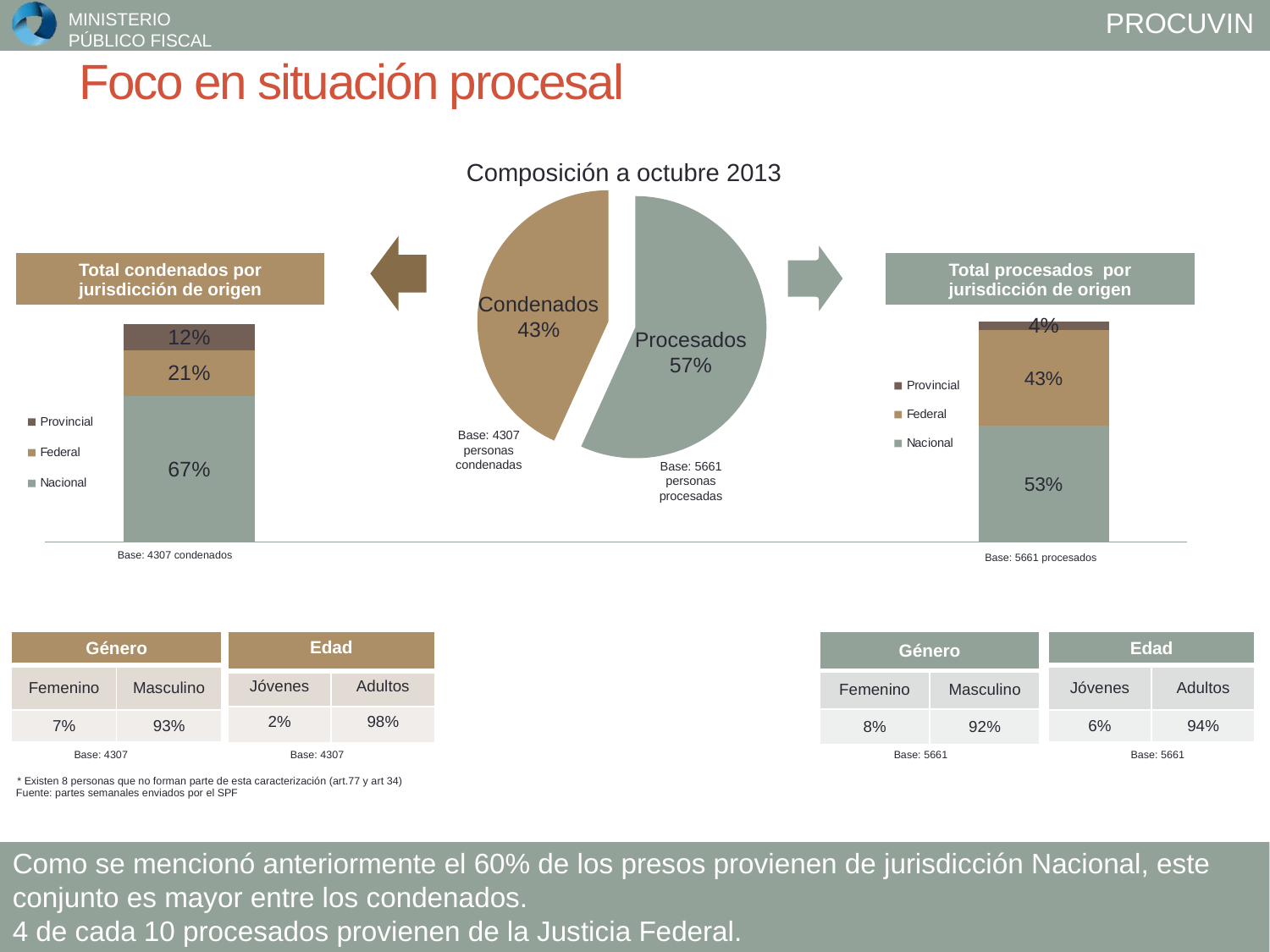
In the chart 'Total condenados por jurisdicción de origen', what is the difference between the Nacional and Federal values? 46% In the chart 'Total condenados por jurisdicción de origen', what is the value for Federal? 21% In the chart 'Total condenados por jurisdicción de origen', what is the value for Nacional? 67% In the pie chart 'Composición a octubre 2013', which slice is larger, Condenados or Procesados? Procesados In the pie chart 'Composición a octubre 2013', what share is labelled for Condenados? 43% In the chart 'Total procesados por jurisdicción de origen', which jurisdiction has the highest value? Nacional In the chart 'Total condenados por jurisdicción de origen', which jurisdiction has the lowest value? Provincial In the pie chart 'Composición a octubre 2013', how many slices are there? 2 In the chart 'Total procesados por jurisdicción de origen', what is the value for Provincial? 4% How many series does the legend of the chart 'Total procesados por jurisdicción de origen' list? 3 In the pie chart 'Composición a octubre 2013', what share is labelled for Procesados? 57% In the chart 'Total procesados por jurisdicción de origen', what is the value for Federal? 43%